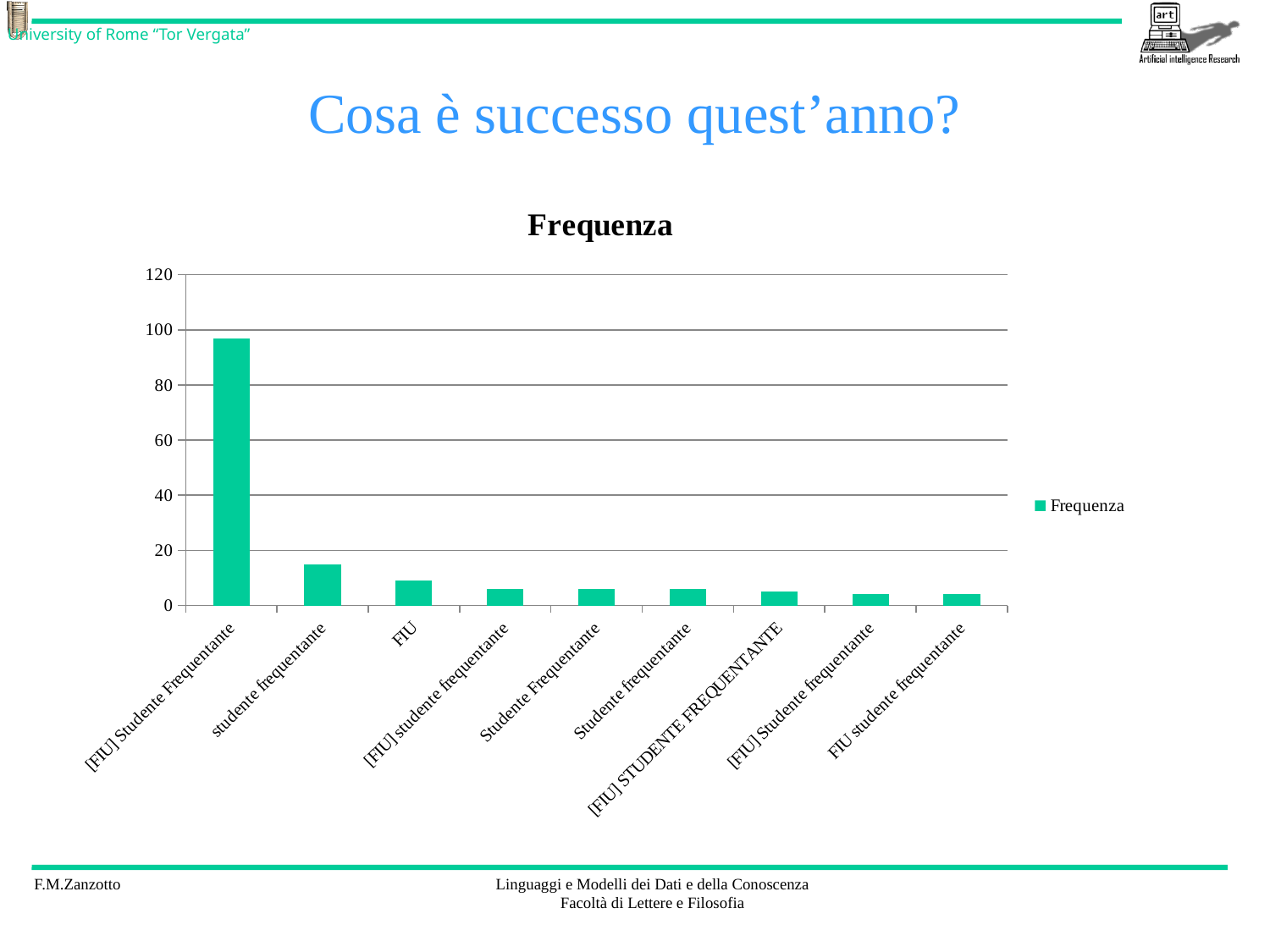
What is the title of the chart? Frequenza Is the value for "studente frequentante" greater or less than 20? less What is the name of the series shown in the legend? Frequenza Do the values rise or fall moving from left to right along the x axis? fall How many categories are plotted on the x axis? 9 Which is larger, the value for "[FIU] Studente Frequentante" or the value for "studente frequentante"? [FIU] Studente Frequentante Is the value for "FIU" greater or less than 20? less Which category has the highest value? [FIU] Studente Frequentante What kind of chart is shown on the slide? bar chart Is the value for "[FIU] Studente Frequentante" greater or less than 80? greater How many series does the legend list? 1